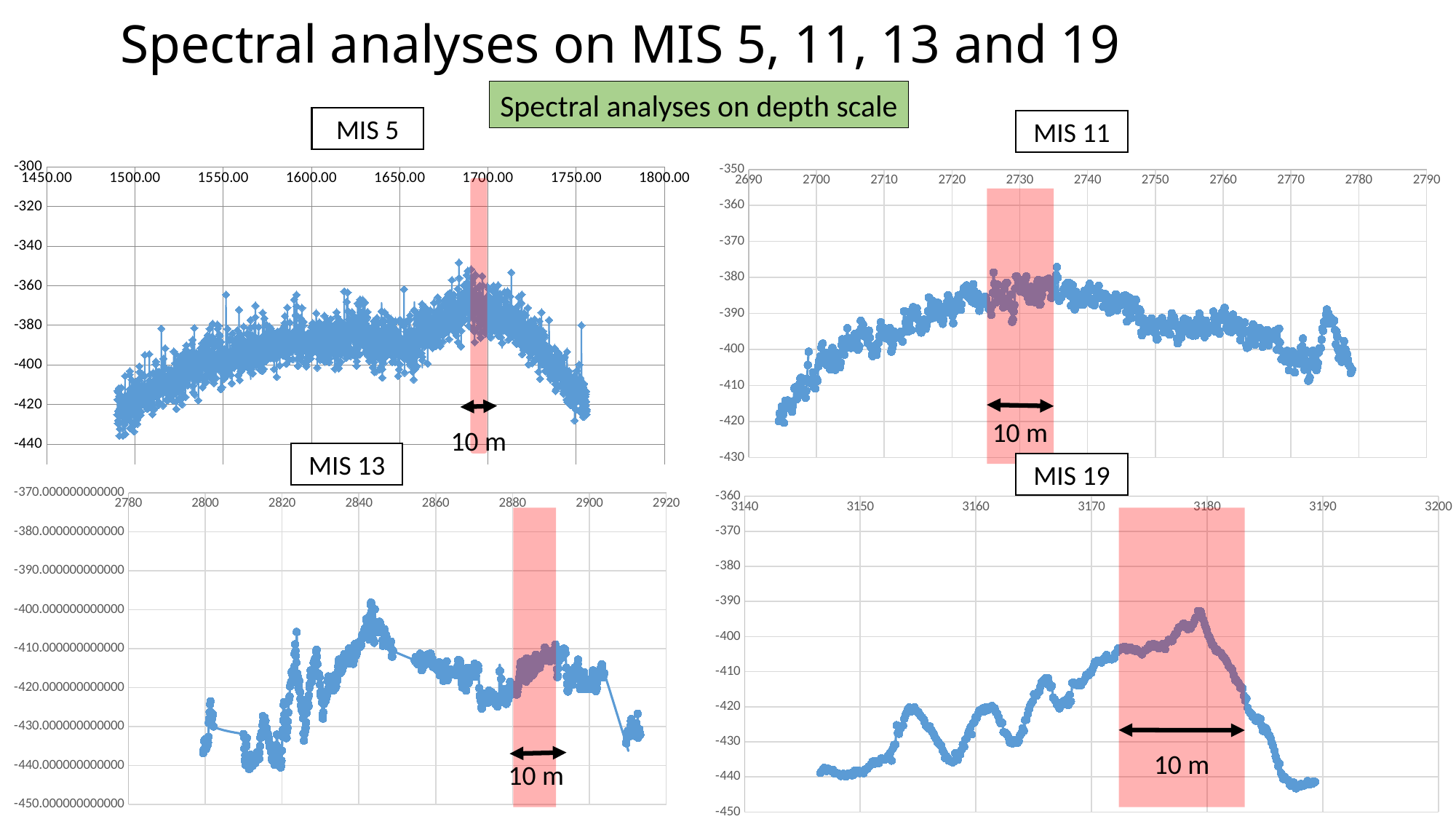
In the MIS 19 chart, is the value at x = 3190 greater or less than -430? less In the MIS 13 chart, is the value at x = 2840 greater or less than -410? greater How many charts are shown on the slide? 4 In the MIS 5 chart, is the value at x = 1500.00 greater or less than -400? less In the MIS 19 chart, do the values generally rise or fall between x = 3180 and x = 3190? fall In the MIS 19 chart, what is the lowest tick value on the y axis? -450 In the MIS 11 chart, what are the lowest and highest values shown on the x axis? 2690 and 2790 In the MIS 19 chart, do the values generally rise or fall between x = 3160 and x = 3180? rise What kind of chart is the MIS 19 chart? line chart In the MIS 5 chart, what are the lowest and highest values shown on the x axis? 1450.00 and 1800.00 In the MIS 11 chart, what width is the shaded red band labelled as? 10 m